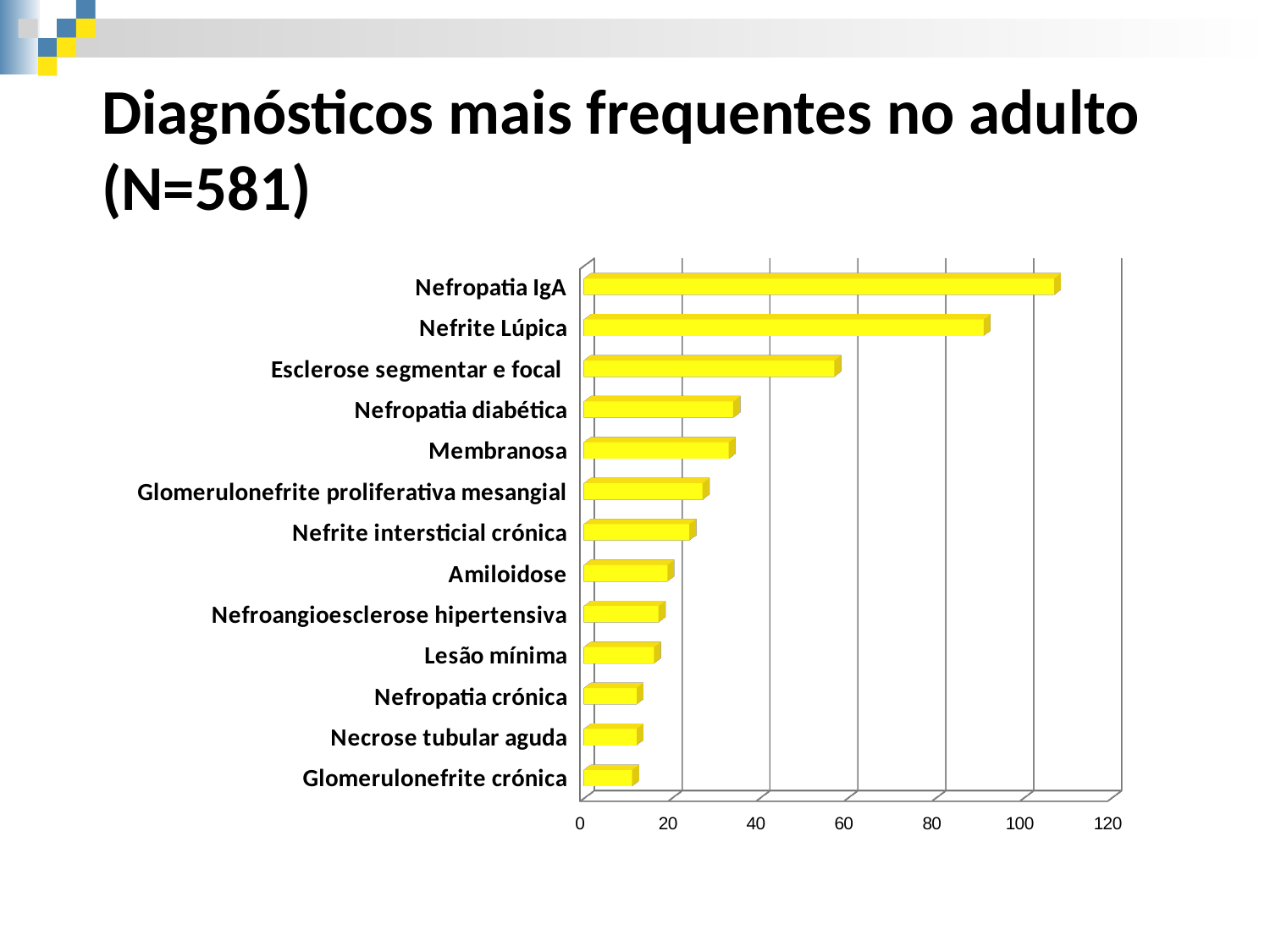
Is the value for Glomerulonefrite crónica greater or less than 20? less Do the bar values increase or decrease going from the top category to the bottom category? decrease Is the value for Nefrite intersticial crónica greater or less than 20? greater What is the title of the slide containing the chart? Diagnósticos mais frequentes no adulto (N=581) Is the value for Nefropatia IgA greater or less than 100? greater Which is larger, the value for Nefrite Lúpica or the value for Esclerose segmentar e focal? Nefrite Lúpica Which diagnosis has the highest value in the chart? Nefropatia IgA What kind of chart is shown on the slide? bar chart How many diagnoses (categories) are plotted in the chart? 13